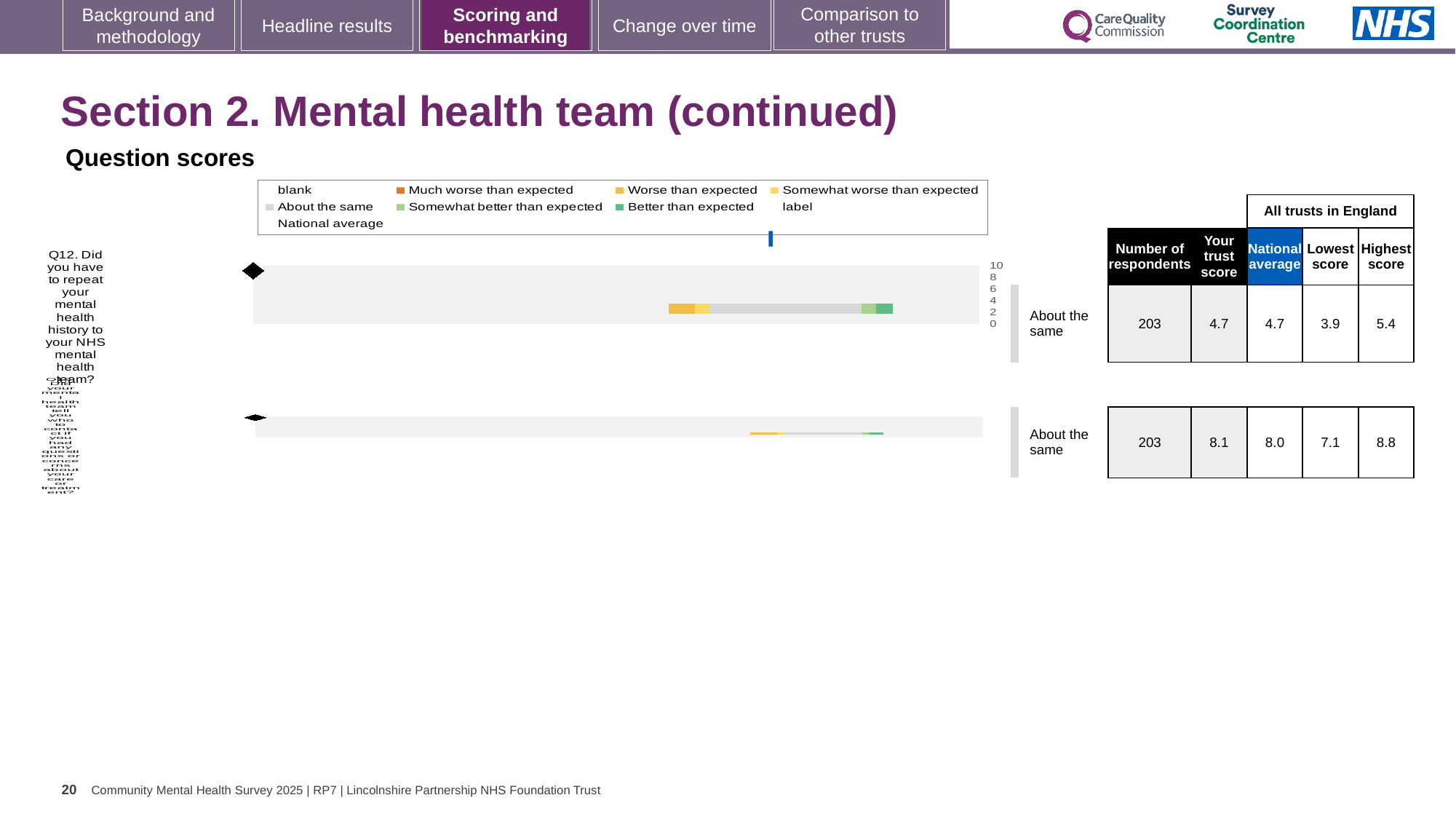
What is the difference between the highest score and the lowest score for Q12? 1.5 What is the highest score among all trusts in England for Q12? 5.4 What is the number of respondents shown for Q12? 203 What is "Your trust score" for Q12? 4.7 For the second (lower) question bar, which is larger: your trust score or the national average? Your trust score What is the national average for Q12? 4.7 What is "Your trust score" for the second (lower) question bar? 8.1 What is the difference between the highest score and the lowest score for the second (lower) question bar? 1.7 How many question bars are plotted in the chart? 2 What colour does the legend use for "Better than expected"? green What benchmark category is shown next to the Q12 bar? About the same What kind of chart is shown under "Question scores"? bar chart